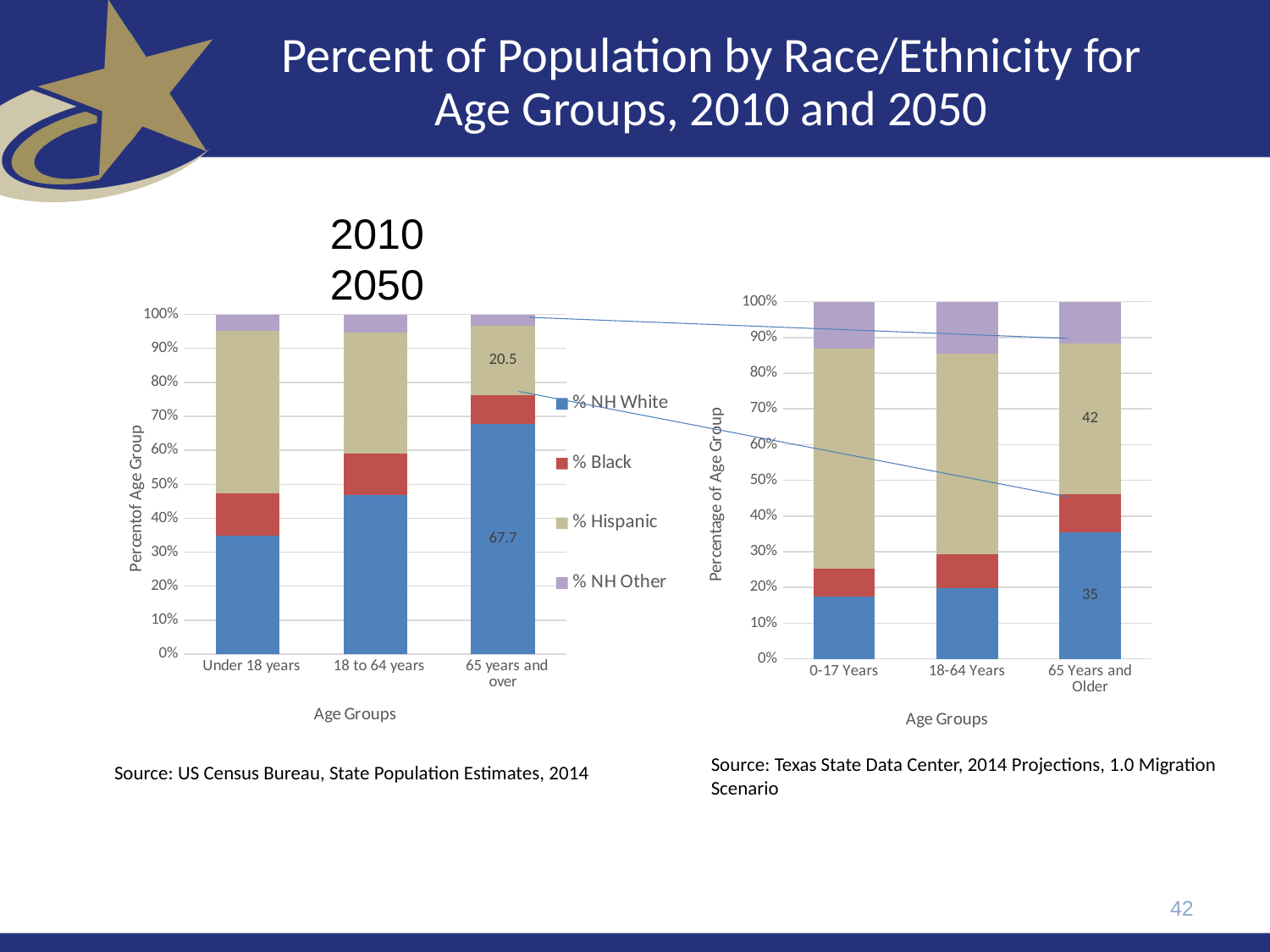
In the 2050 chart on the right, is the % NH White value for 0-17 Years greater or less than 20%? less How many series does the legend list? 4 How much larger is the % Hispanic value for the 65 and over group in the 2050 chart than in the 2010 chart? 21.5 In the 2010 chart on the left, is the % NH White value for Under 18 years greater or less than 40%? less In the 2010 chart on the left, what is the % Hispanic value for the 65 years and over group? 20.5 In the 2050 chart on the right, what is the % NH White value for the 65 Years and Older group? 35 In the 2010 chart on the left, which age group has the highest % NH White share? 65 years and over In the 2050 chart on the right, which age group has the lowest % NH White share? 0-17 Years In the 2010 chart on the left, what is the % NH White value for the 65 years and over group? 67.7 What kind of chart is the 2050 chart on the right? Stacked bar chart How much larger is the % NH White value for the 65 and over group in the 2010 chart than in the 2050 chart? 32.7 In the 2050 chart on the right, what is the % Hispanic value for the 65 Years and Older group? 42